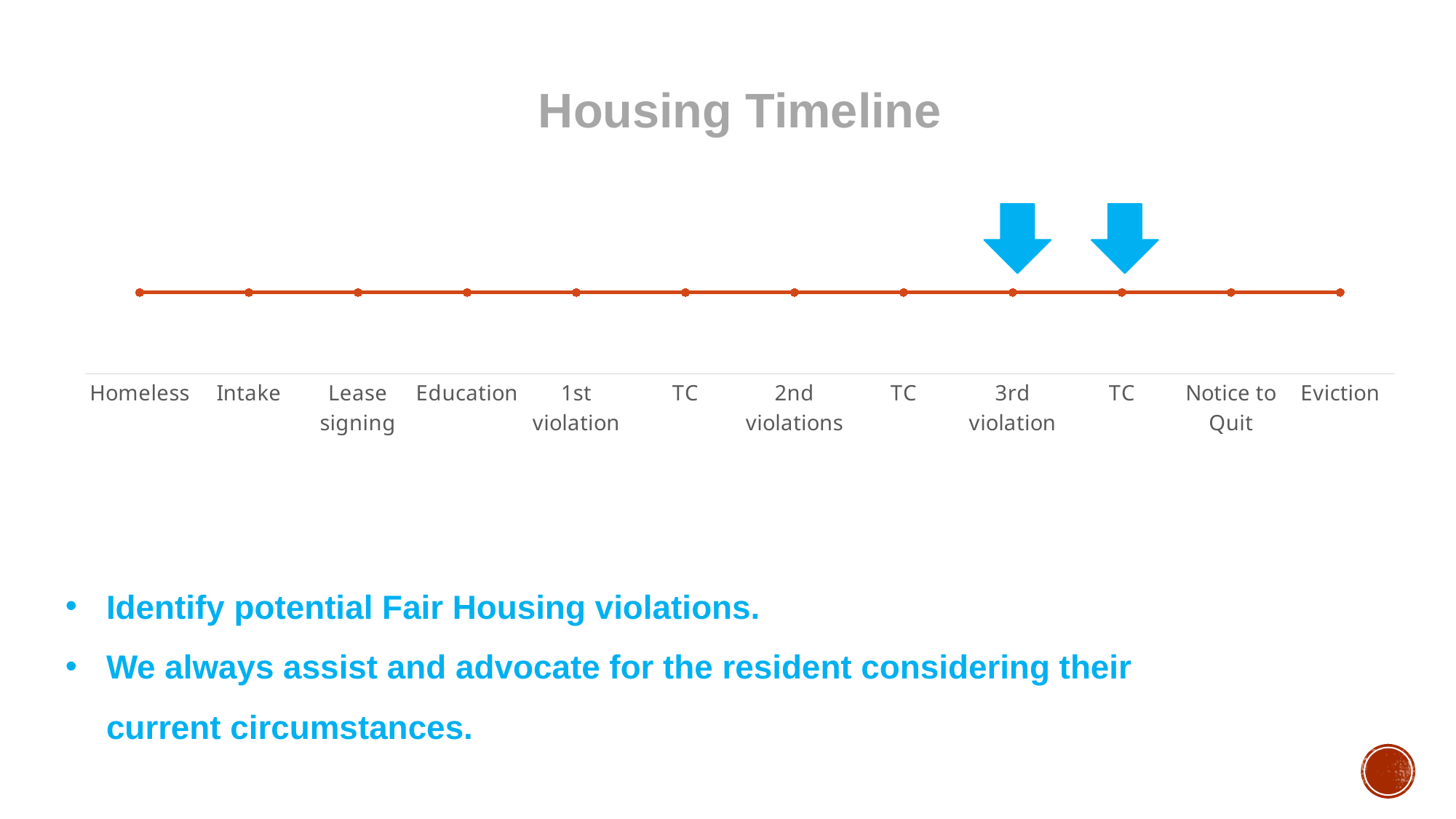
What kind of chart is shown on the slide? Line chart Do the plotted values rise, fall, or stay flat along the x axis? Stay flat How many data points are marked on the line in the chart? 12 Which category is the first on the x axis of the chart? Homeless How many categories are plotted along the x axis of the chart? 12 What is the title of the chart? Housing Timeline